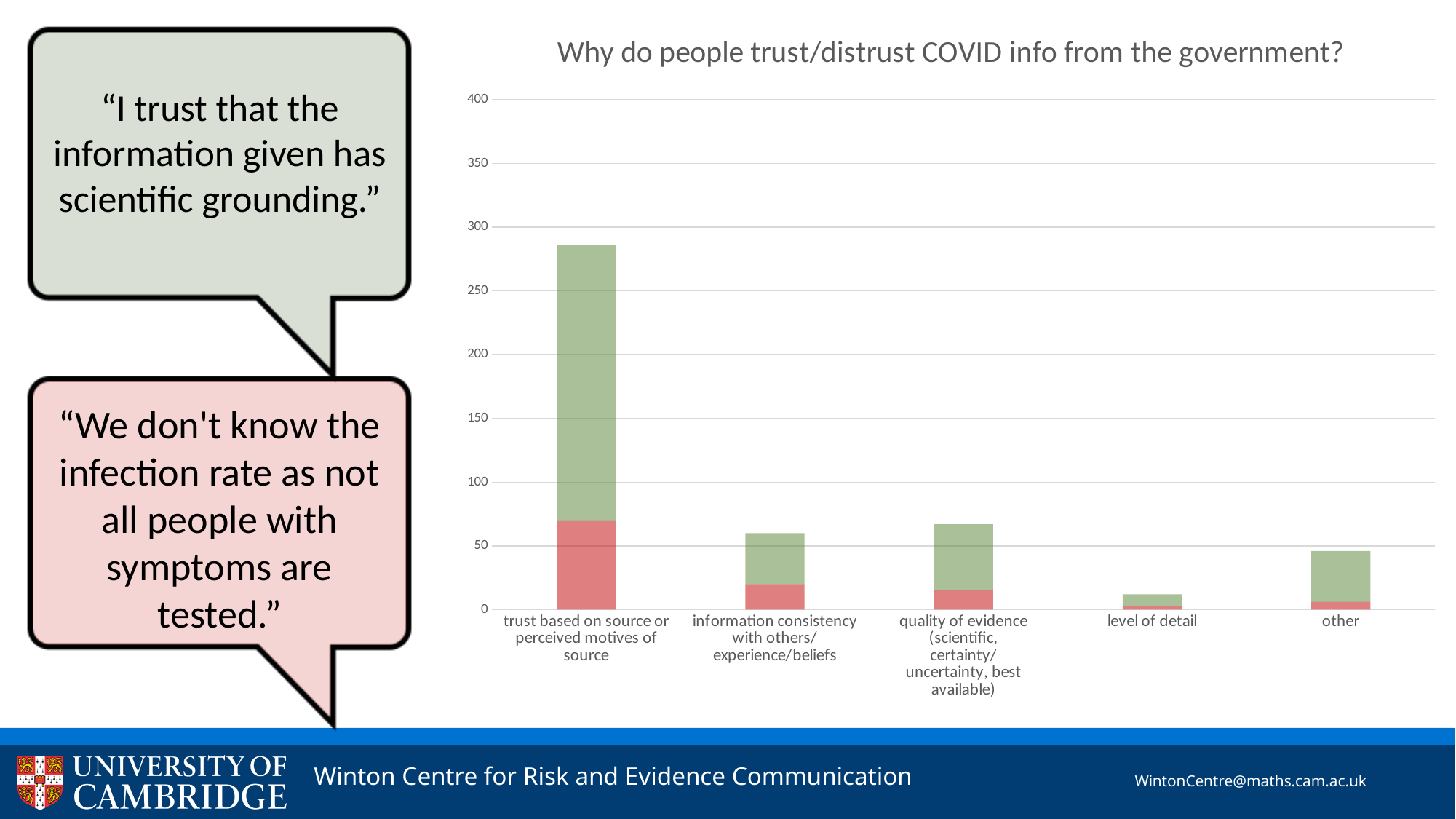
How many categories are shown on the x axis of the chart? 5 What is the title of the chart? Why do people trust/distrust COVID info from the government? What kind of chart is shown on the slide? stacked bar chart Which category has the shortest bar in the chart? level of detail Which category has the tallest bar in the chart? trust based on source or perceived motives of source Which bar is taller: 'other' or 'level of detail'? other Is the total bar for 'level of detail' greater or less than 50? less Is the total bar for 'trust based on source or perceived motives of source' greater or less than 300? less Which bar is taller: 'trust based on source or perceived motives of source' or 'quality of evidence (scientific, certainty/uncertainty, best available)'? trust based on source or perceived motives of source Is the total bar for 'quality of evidence (scientific, certainty/uncertainty, best available)' greater or less than 50? greater